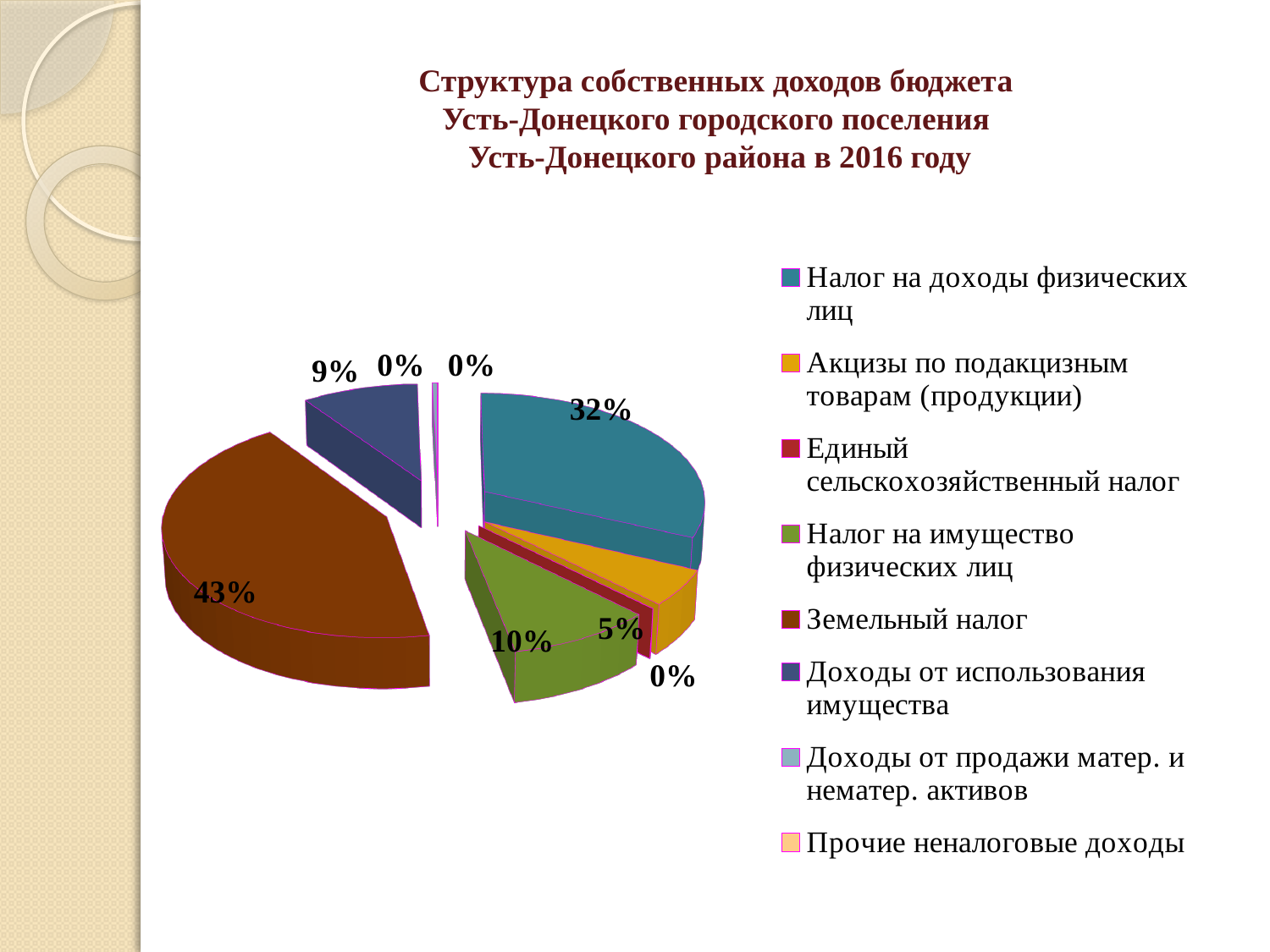
What percentage is shown for Налог на имущество физических лиц? 10% How many categories does the legend list? 8 What share of the budget's own revenues comes from Земельный налог? 43% What type of chart is shown on the slide? pie chart What percentage is shown for Доходы от использования имущества? 9% What percentage is shown for Налог на доходы физических лиц? 32% What is the difference in percentage points between Земельный налог and Налог на доходы физических лиц? 11 Which year does the chart title refer to? 2016 Which is larger: the share for Налог на имущество физических лиц or the share for Доходы от использования имущества? Налог на имущество физических лиц What percentage is shown for Единый сельскохозяйственный налог? 0% What percentage is shown for Акцизы по подакцизным товарам (продукции)? 5% Which revenue source has the largest share of the pie? Земельный налог